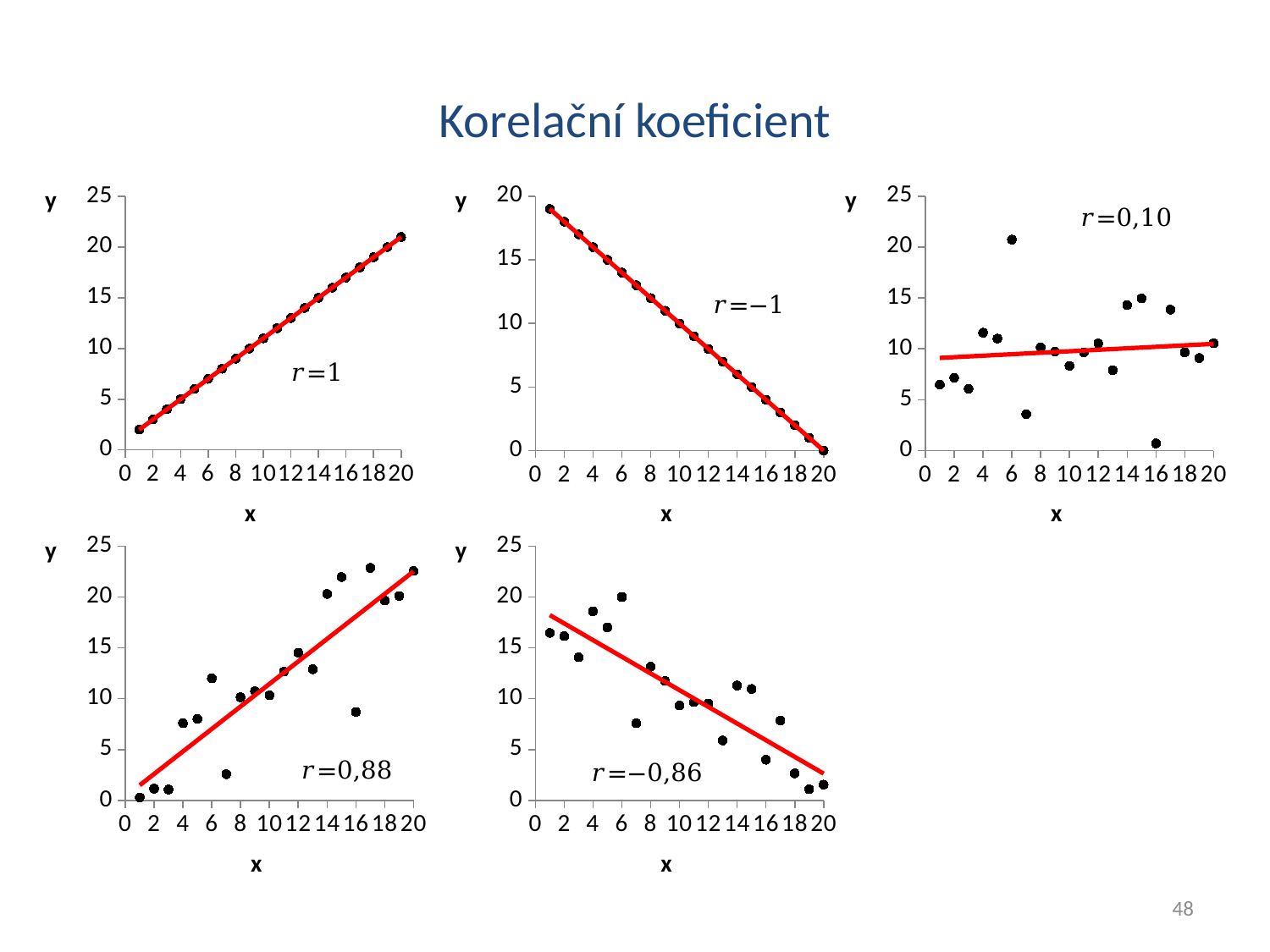
How many data points are plotted in the top-left chart? 20 In the bottom-middle chart, is the y value at x = 6 greater or less than 15? greater In the top-middle chart, is the y value at x = 1 greater or less than 15? greater In the top-right chart, is the y value at x = 16 greater or less than 5? less What correlation coefficient is annotated on the bottom-middle chart? r=−0,86 In the top-middle chart, do the y values rise or fall as x increases? fall In the top-left chart, do the y values rise or fall as x increases? rise In the bottom-left chart, do the y values generally rise or fall as x increases? rise What kind of chart is the top-left chart on the slide? scatter chart What correlation coefficient is annotated on the top-right chart? r=0,10